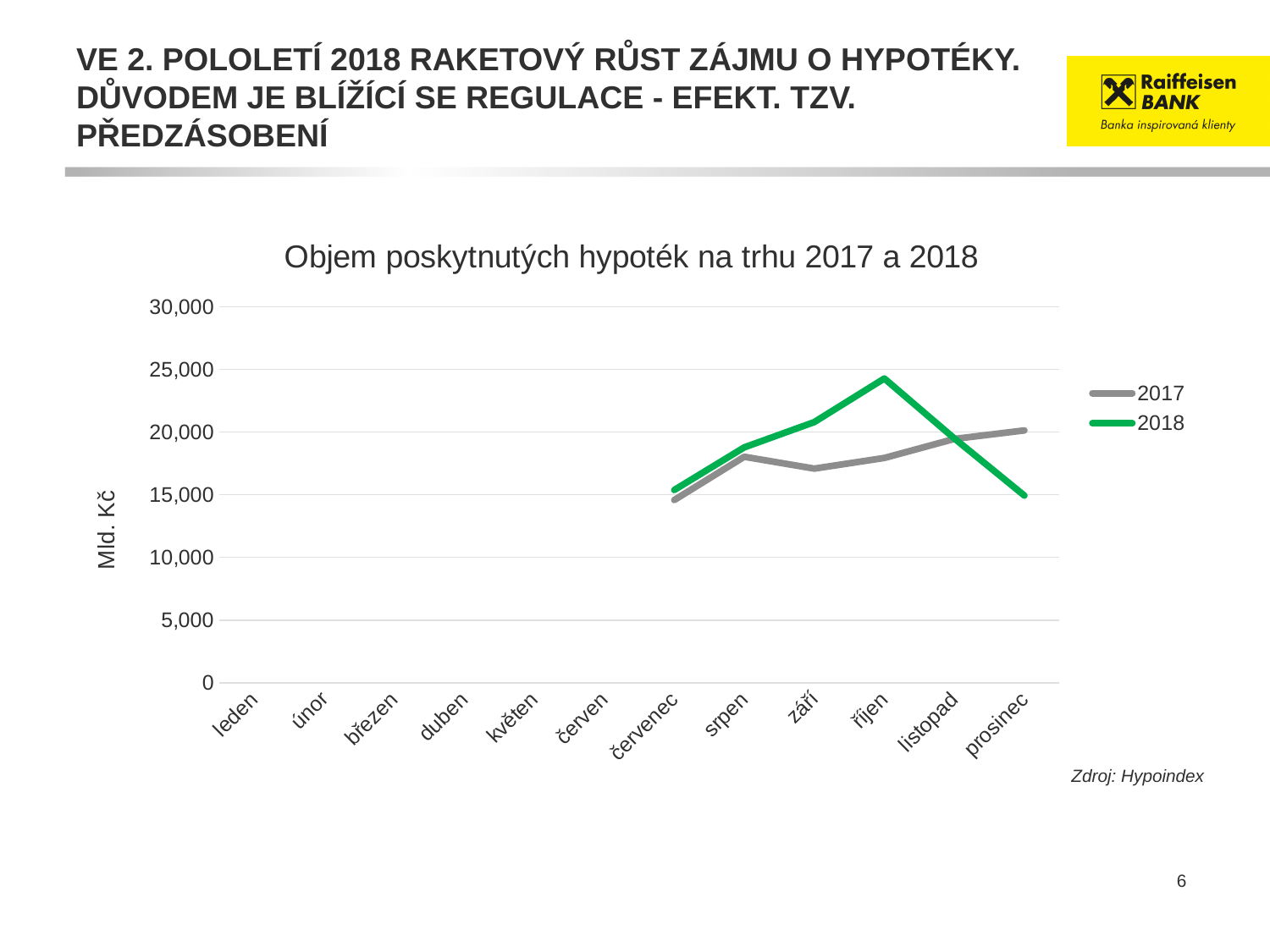
In which month does the 2018 series reach its highest value? říjen Is the value for 2017 in září greater or less than 20,000? less Is the value for 2017 in červenec greater or less than 15,000? less What kind of chart is shown on the slide? line chart How many month categories are shown on the x axis? 12 In which month does the 2017 series have its lowest value? červenec Does the 2018 series rise or fall from říjen to prosinec? fall Which series has the larger value in říjen, 2017 or 2018? 2018 Which series has the larger value in prosinec, 2017 or 2018? 2017 How many series does the legend list? 2 What is the title of the chart? Objem poskytnutých hypoték na trhu 2017 a 2018 Is the value for 2018 in říjen greater or less than 20,000? greater